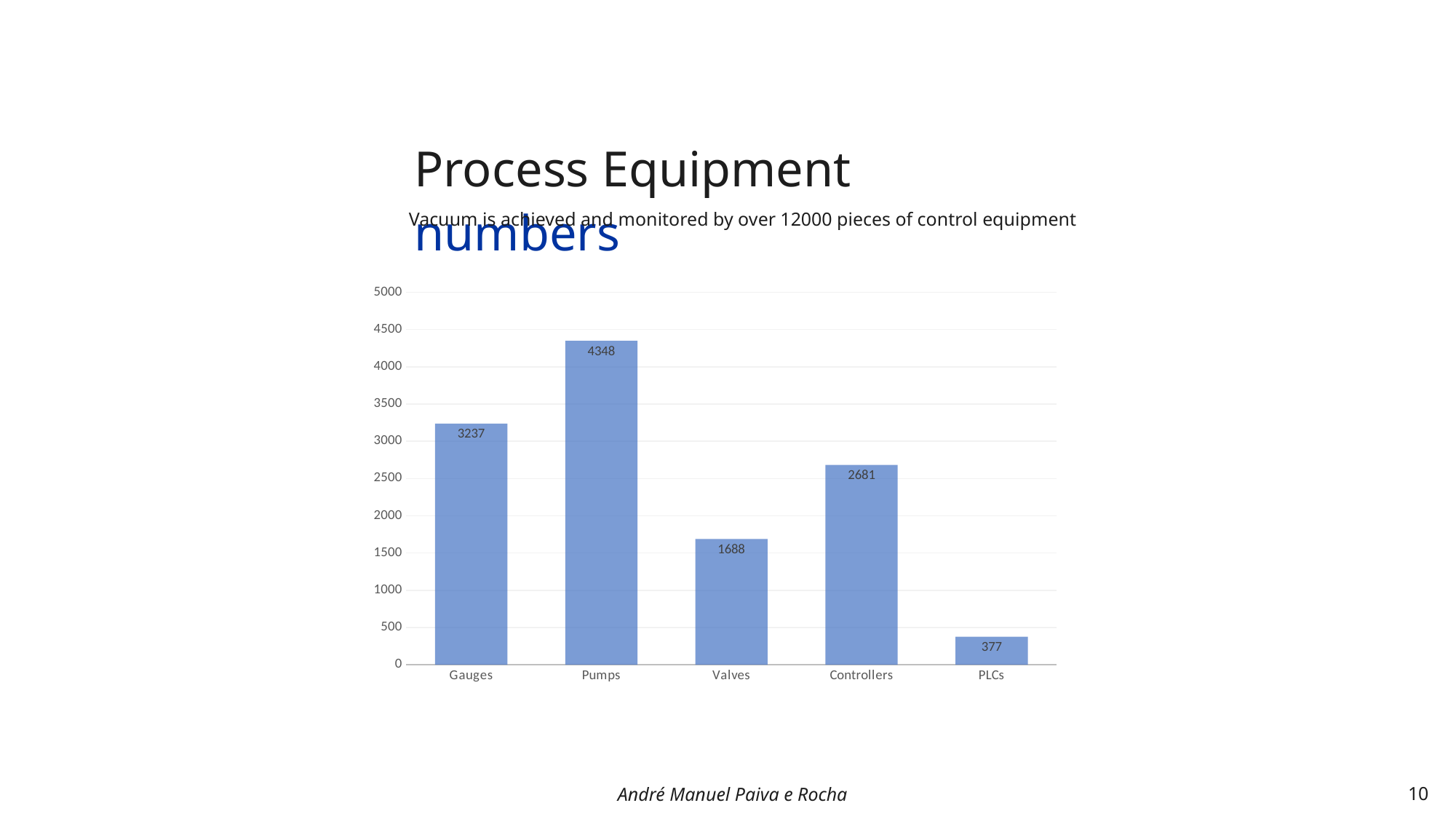
What is the value for Gauges? 3237 What is the difference between the values for Pumps and Gauges? 1111 Which category has the highest value? Pumps Is the value for Controllers greater or less than 2500? greater What is the value for Pumps? 4348 What is the difference between the values for Controllers and Valves? 993 How many categories are shown on the x axis? 5 What is the value for PLCs? 377 What is the value for Valves? 1688 What kind of chart is shown on the slide? Bar chart Which is larger, the value for Gauges or the value for Controllers? Gauges Which category has the lowest value? PLCs